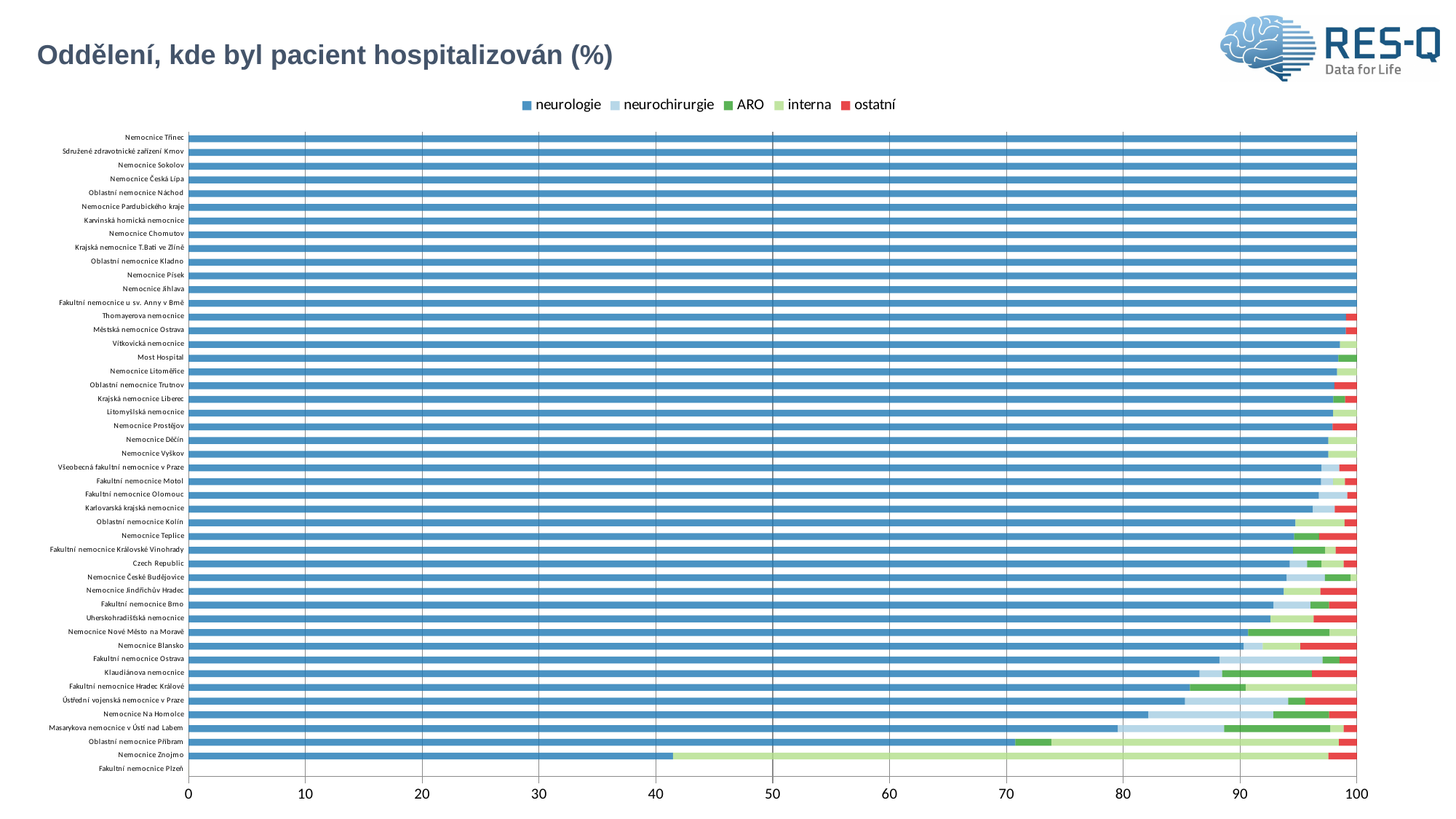
Which has the larger neurologie value, Nemocnice Znojmo or Oblastní nemocnice Příbram? Oblastní nemocnice Příbram Is the neurologie value for Nemocnice Třinec greater or less than 90? greater Is the neurologie value for Nemocnice Na Homolce greater or less than 80? greater Is the neurologie value for Nemocnice Znojmo greater or less than 50? less How many series does the legend list? 5 What kind of chart is shown on the slide? Stacked bar chart Which hospital has the largest interna segment? Nemocnice Znojmo Which series is shown in red in the legend? ostatní What is the title of the chart? Oddělení, kde byl pacient hospitalizován (%) Which has the larger neurologie value, Nemocnice Na Homolce or Nemocnice Znojmo? Nemocnice Na Homolce